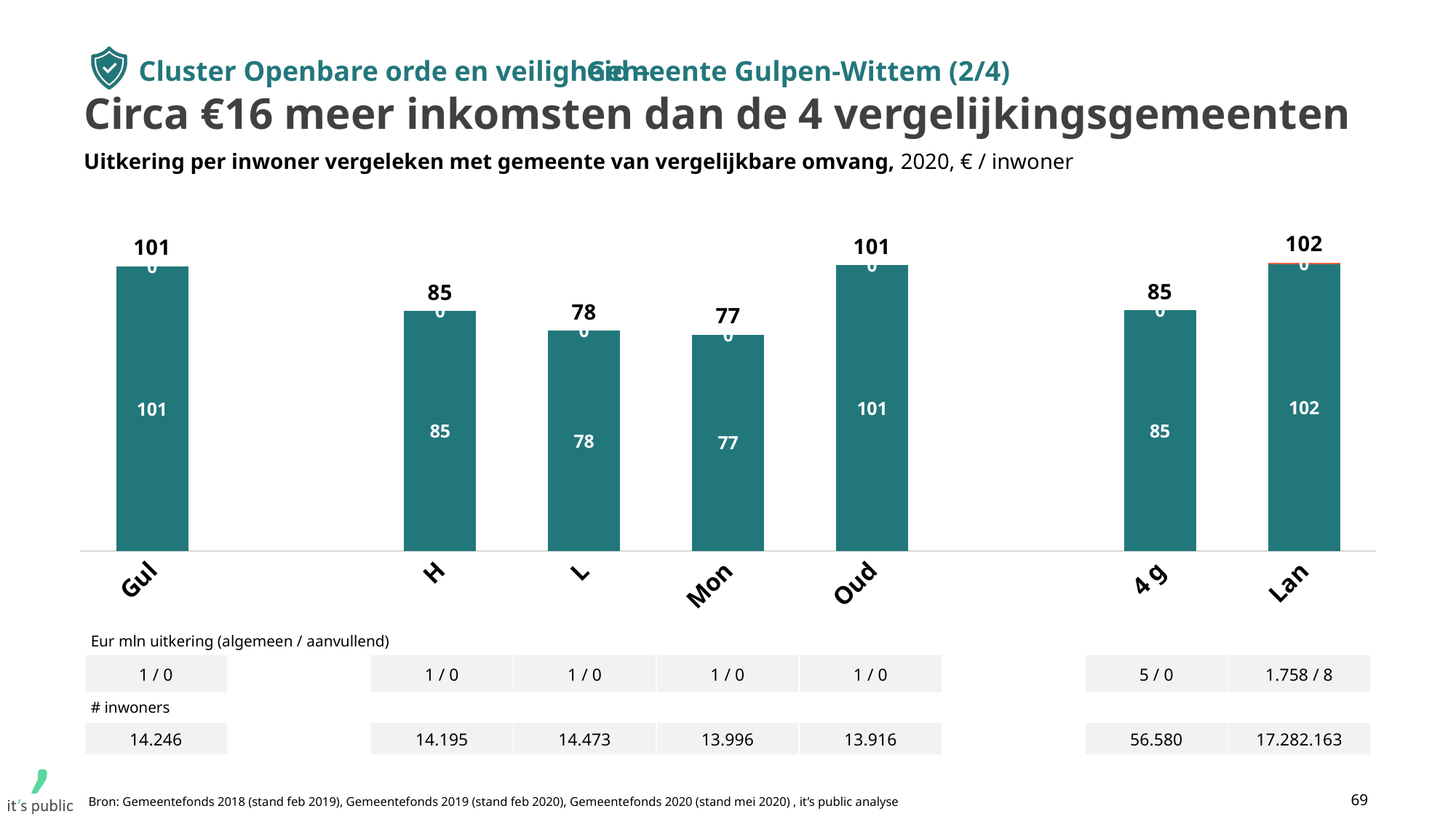
What is the difference between the values for Gul and H? 16 How many categories are shown on the x axis? 7 What is the difference between the values for Lan and L? 24 What unit is stated in the chart subtitle for the values? € / inwoner What is the value for Gul? 101 What is the value for 4 g? 85 What is the value for Mon? 77 What is the value for Lan? 102 Which category has the lowest value? Mon Which is larger, the value for L or the value for Mon? L What kind of chart is shown on the slide? bar chart Which category has the highest value? Lan